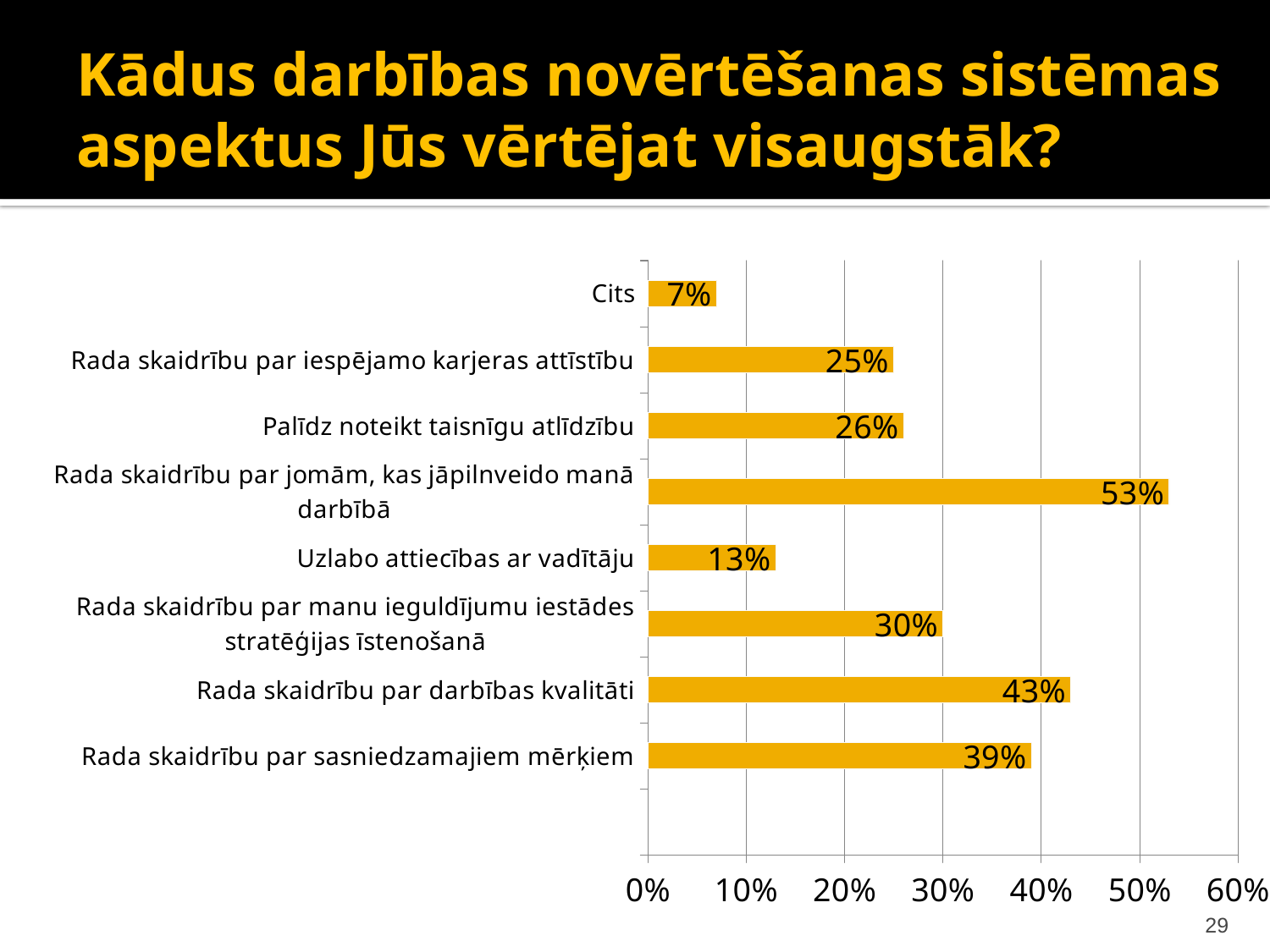
What is the value for "Uzlabo attiecības ar vadītāju"? 13% What is the difference between "Rada skaidrību par darbības kvalitāti" and "Rada skaidrību par sasniedzamajiem mērķiem"? 4% Which category has the highest value? Rada skaidrību par jomām, kas jāpilnveido manā darbībā How many categories are shown in the chart? 8 What is the value for "Rada skaidrību par sasniedzamajiem mērķiem"? 39% What is the value for "Cits"? 7% Which category has the lowest value? Cits What is the value for "Rada skaidrību par jomām, kas jāpilnveido manā darbībā"? 53% Which is larger: "Palīdz noteikt taisnīgu atlīdzību" or "Rada skaidrību par manu ieguldījumu iestādes stratēģijas īstenošanā"? Rada skaidrību par manu ieguldījumu iestādes stratēģijas īstenošanā What is the maximum value shown on the x axis? 60% Is the value for "Rada skaidrību par darbības kvalitāti" greater or less than 40%? greater What kind of chart is shown on the slide? bar chart